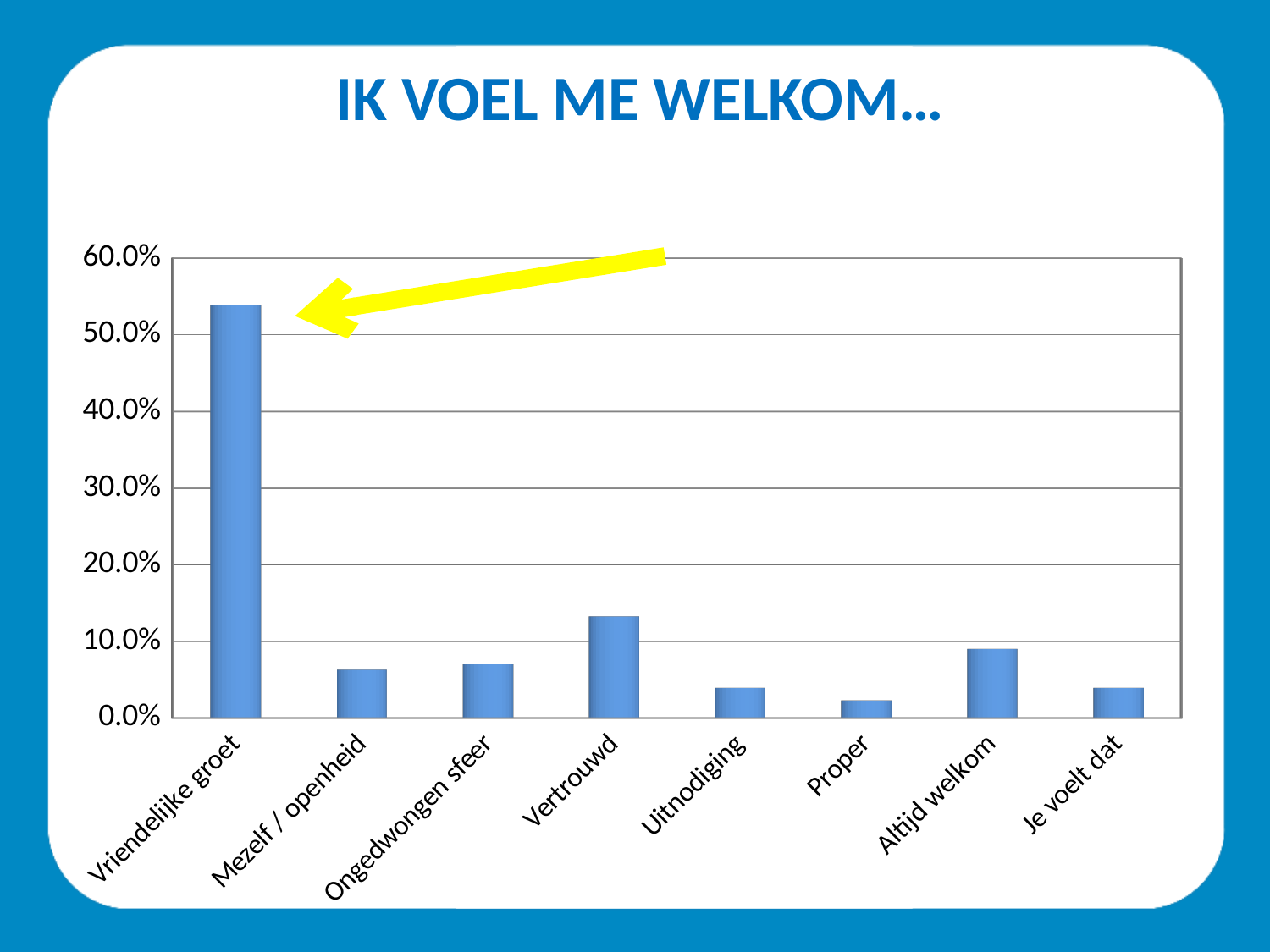
Is the value for Altijd welkom greater or less than 10.0%? less Which bar does the yellow arrow on the chart point to? Vriendelijke groet Which has a larger value, Vertrouwd or Altijd welkom? Vertrouwd What kind of chart is shown on the slide? Bar chart Which has a larger value, Ongedwongen sfeer or Proper? Ongedwongen sfeer Is the value for Mezelf / openheid greater or less than 10.0%? less Which category has the highest value in the chart? Vriendelijke groet What is the title of the slide containing the chart? IK VOEL ME WELKOM… Is the value for Vertrouwd greater or less than 10.0%? greater Which category has the lowest value in the chart? Proper How many categories are shown on the x axis of the chart? 8